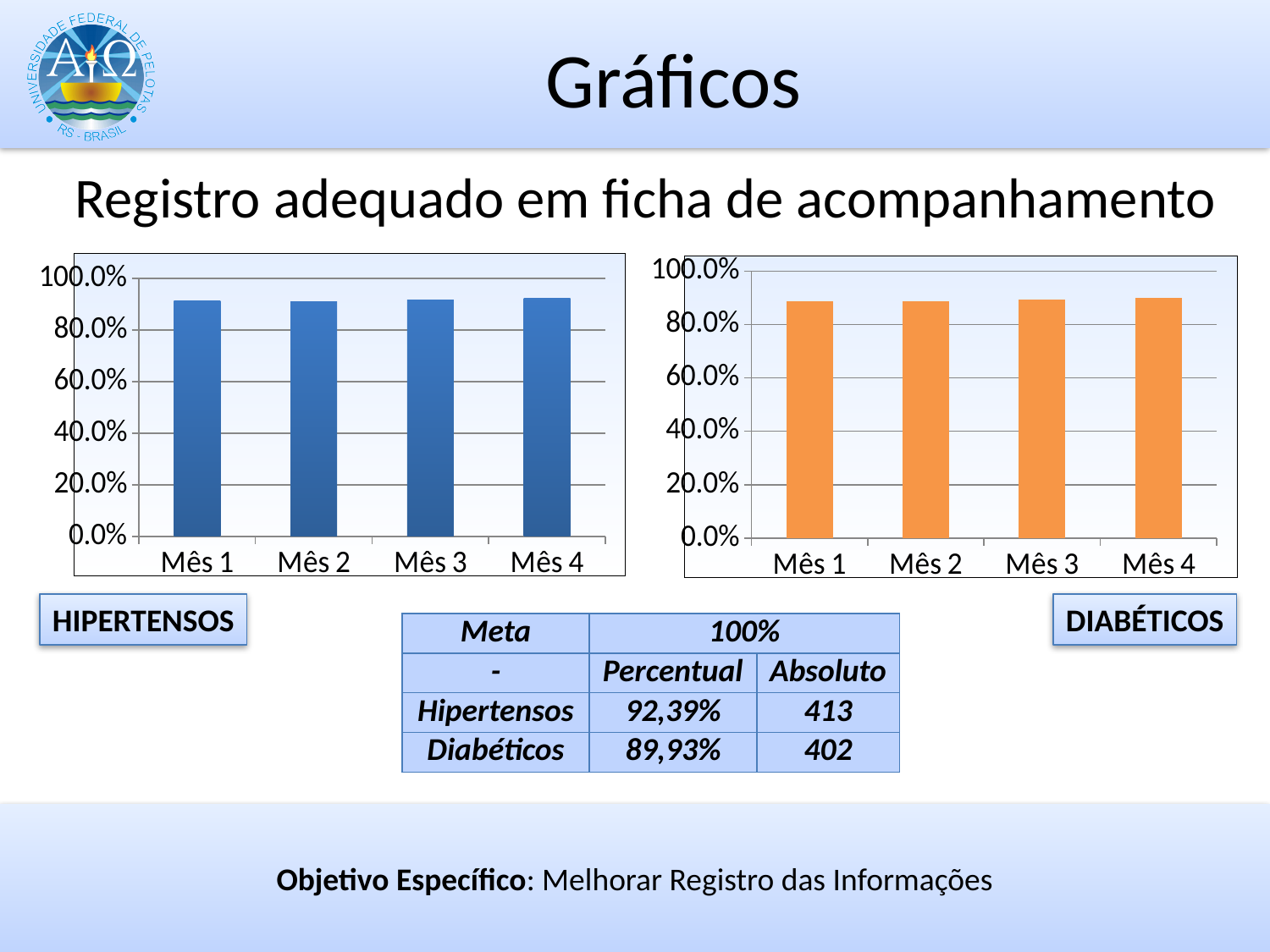
On the HIPERTENSOS chart, is the value for Mês 4 greater or less than 100.0%? less How many categories (months) are shown on the HIPERTENSOS chart? 4 What is the label of the first category on the x axis of the DIABÉTICOS chart? Mês 1 What colour are the bars on the DIABÉTICOS chart? orange On the DIABÉTICOS chart, is the value for Mês 3 greater or less than 100.0%? less What kind of chart is the HIPERTENSOS chart on the left? bar chart What kind of chart is the DIABÉTICOS chart on the right? bar chart On the HIPERTENSOS chart, is the value for Mês 3 greater or less than 60.0%? greater How many categories (months) are shown on the DIABÉTICOS chart? 4